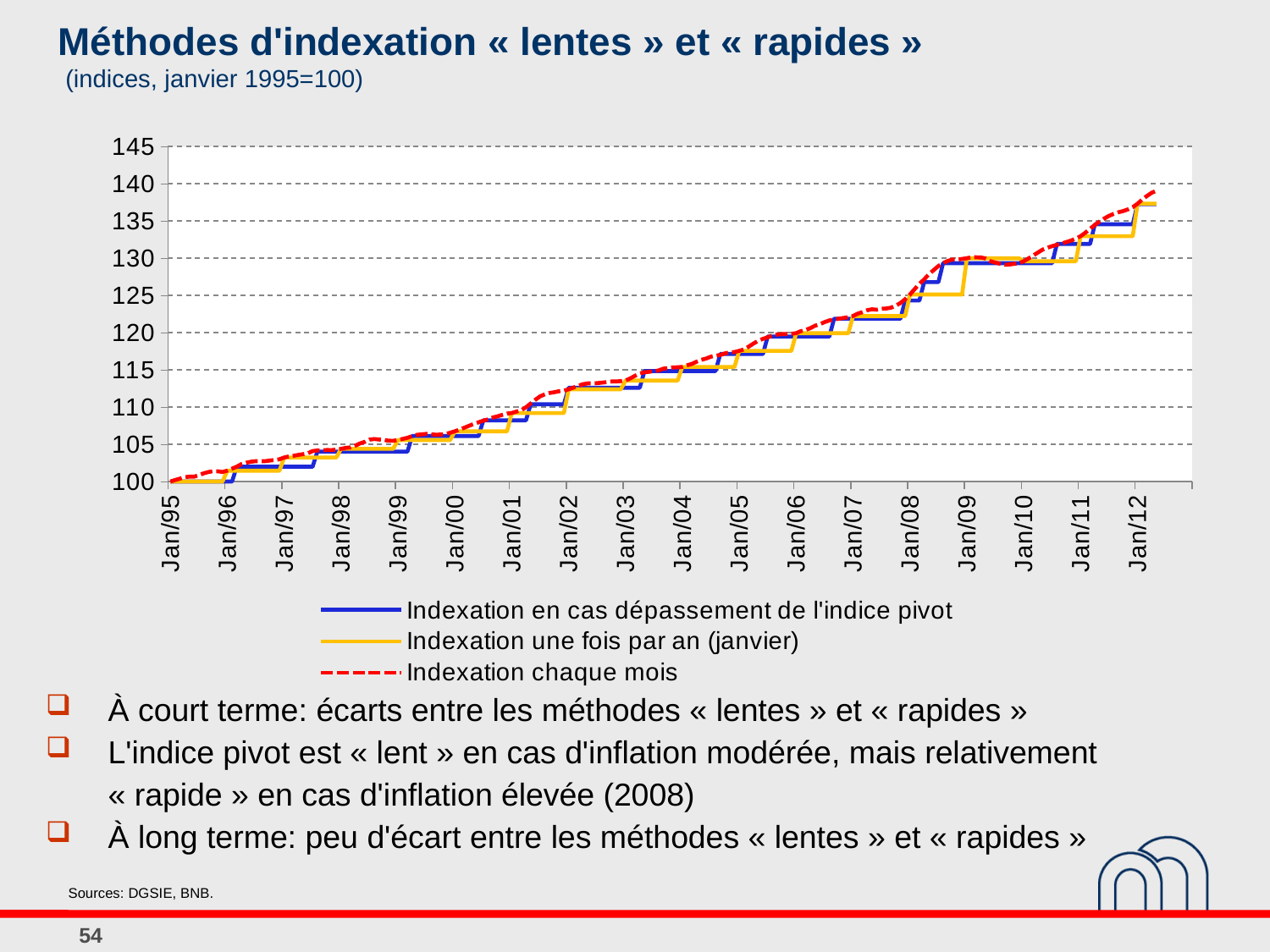
Is the value of 'Indexation chaque mois' at Jan/09 greater or less than 125? greater How many year labels are shown on the x axis? 18 Do the index values rise or fall from Jan/95 to Jan/12? rise What is the value of the indices at Jan/95, the base period? 100 What kind of chart is shown on the slide? line chart How many series does the legend list? 3 What is the title of the chart? Méthodes d'indexation « lentes » et « rapides » Is the value of 'Indexation chaque mois' at Jan/03 greater or less than 110? greater Is the value of 'Indexation une fois par an (janvier)' at Jan/12 greater or less than 130? greater Which series is drawn as a red dashed line? Indexation chaque mois